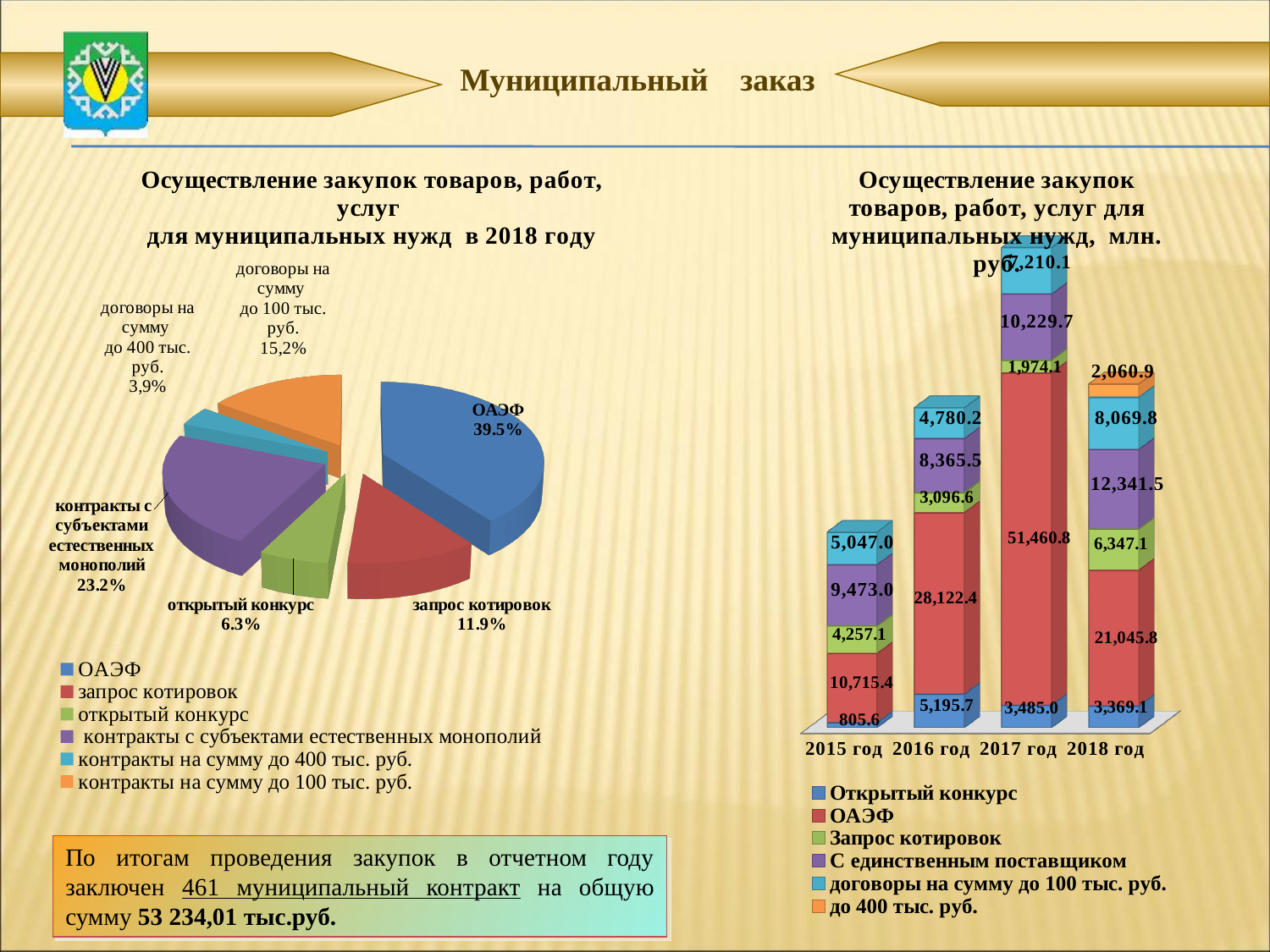
How many series does the legend of the bar chart on the right list? 6 In the pie chart on the left, what share do договоры на сумму до 100 тыс. руб. have? 15,2% In the pie chart on the left, which category has the largest share? ОАЭФ In the bar chart on the right, what is the difference between the ОАЭФ values for 2017 год and 2016 год? 23,338.4 In the pie chart on the left, what share does ОАЭФ have? 39.5% How many years are shown on the x axis of the bar chart on the right? 4 In the bar chart on the right, which is larger: С единственным поставщиком in 2018 год or in 2017 год? 2018 год In the bar chart on the right, what is the value for ОАЭФ in 2017 год? 51,460.8 In the bar chart on the right, what is the value for Открытый конкурс in 2015 год? 805.6 In the pie chart on the left, what is the difference between the shares of ОАЭФ and запрос котировок? 27.6% In the pie chart on the left, which category has the smallest share? договоры на сумму до 400 тыс. руб. In the bar chart on the right, in which year is the ОАЭФ value highest? 2017 год